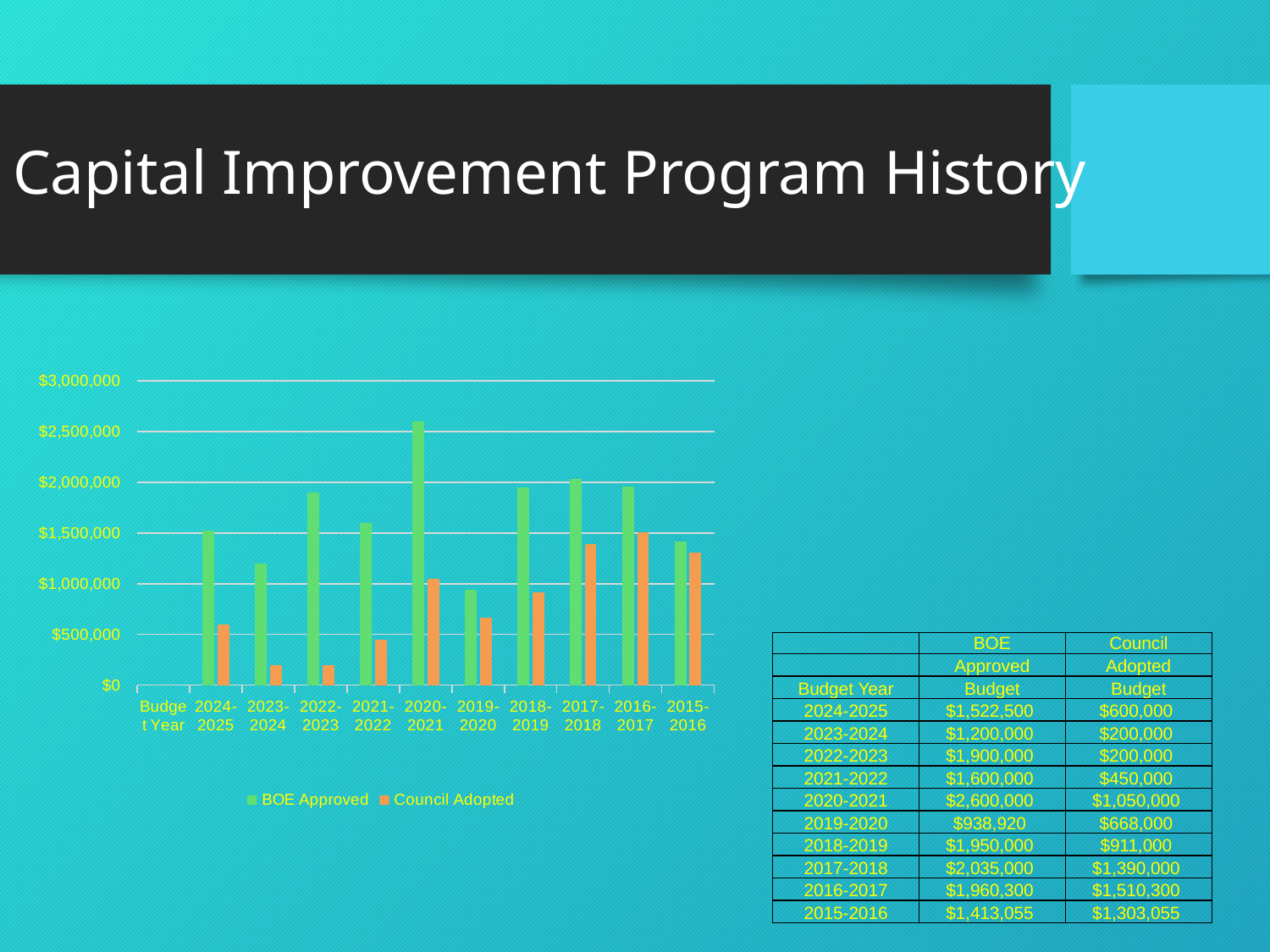
Which budget year has the lowest BOE Approved value? 2019-2020 What is the BOE Approved budget for 2020-2021? $2,600,000 What is the Council Adopted budget for 2024-2025? $600,000 Is the BOE Approved value for 2020-2021 greater or less than $2,500,000? greater Which budget year has the highest Council Adopted value? 2016-2017 Is the Council Adopted value for 2023-2024 greater or less than $500,000? less Which budget year has the highest BOE Approved value? 2020-2021 Which is larger for 2021-2022, the BOE Approved value or the Council Adopted value? BOE Approved How many series does the chart legend list? 2 Which colour represents the Council Adopted series in the chart? orange What is the difference between the BOE Approved and Council Adopted budgets for 2024-2025? $922,500 What kind of chart is shown on the slide? bar chart